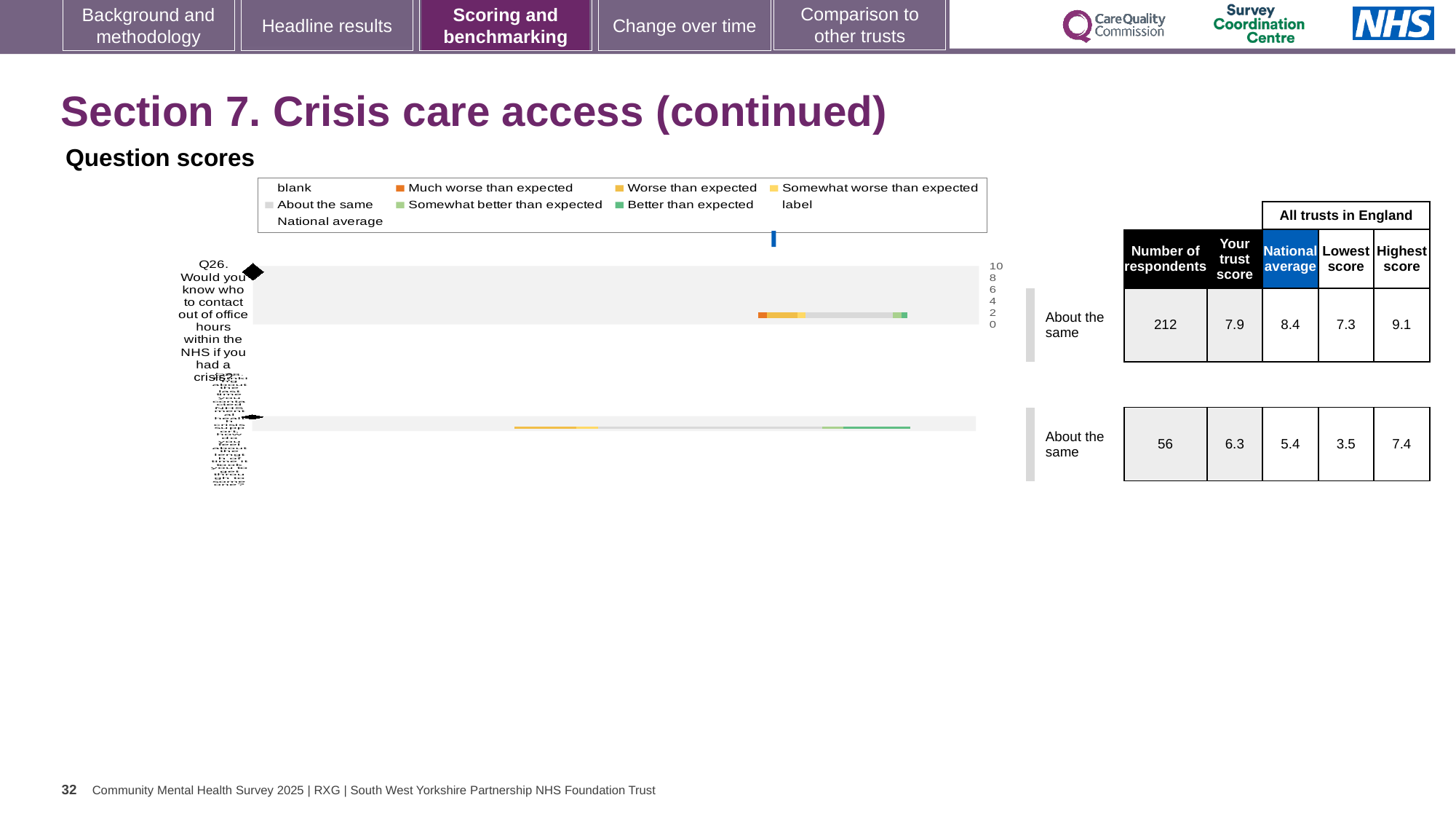
What kind of chart is shown under 'Question scores'? bar chart In the table beside the chart, what is the number of respondents for Q26? 212 What is the full label of the first question plotted in the chart? Q26. Would you know who to contact out of office hours within the NHS if you had a crisis? In the table beside the chart, what is 'Your trust score' for the second question row? 6.3 For Q26, which is larger: your trust score or the national average? National average How many question rows are plotted in the Question scores chart? 2 In the table beside the chart, what is the highest score across all trusts in England for Q26? 9.1 For Q26, what is the difference between the national average and your trust score? 0.5 In the table beside the chart, what is 'Your trust score' for Q26? 7.9 What is the highest tick value shown on the chart's score axis? 10 In the table beside the chart, what is the national average for Q26? 8.4 What benchmark category is shown next to the Q26 bar? About the same